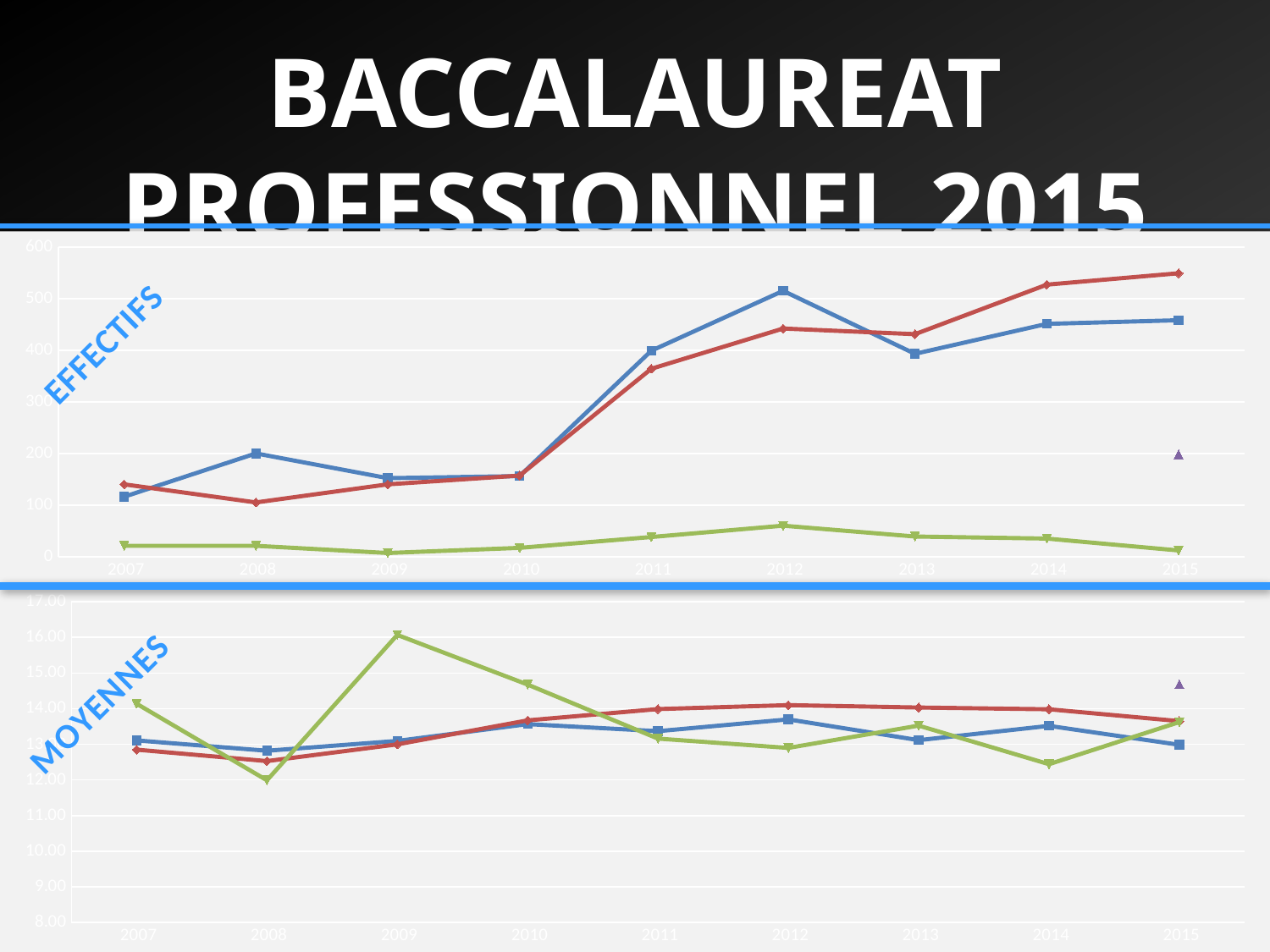
In the top chart (EFFECTIFS), is the value of the green line in 2012 greater or less than 100? less In the top chart (EFFECTIFS), does the red line rise or fall overall between 2010 and 2015? rise What kind of chart is the bottom chart labelled MOYENNES? line chart What kind of chart is the top chart labelled EFFECTIFS? line chart In the top chart (EFFECTIFS), which line is higher in 2012, the blue line or the red line? the blue line In the bottom chart (MOYENNES), in which year does the green line reach its lowest value? 2008 In the top chart (EFFECTIFS), in which year does the red line reach its highest value? 2015 In the top chart (EFFECTIFS), how many years are shown on the x axis? 9 In the bottom chart (MOYENNES), is the value of the green line in 2009 greater or less than 15.00? greater In the top chart (EFFECTIFS), in which year does the blue line reach its highest value? 2012 In the bottom chart (MOYENNES), in which year does the green line reach its highest value? 2009 In the top chart (EFFECTIFS), is the value of the red line in 2015 greater or less than 500? greater